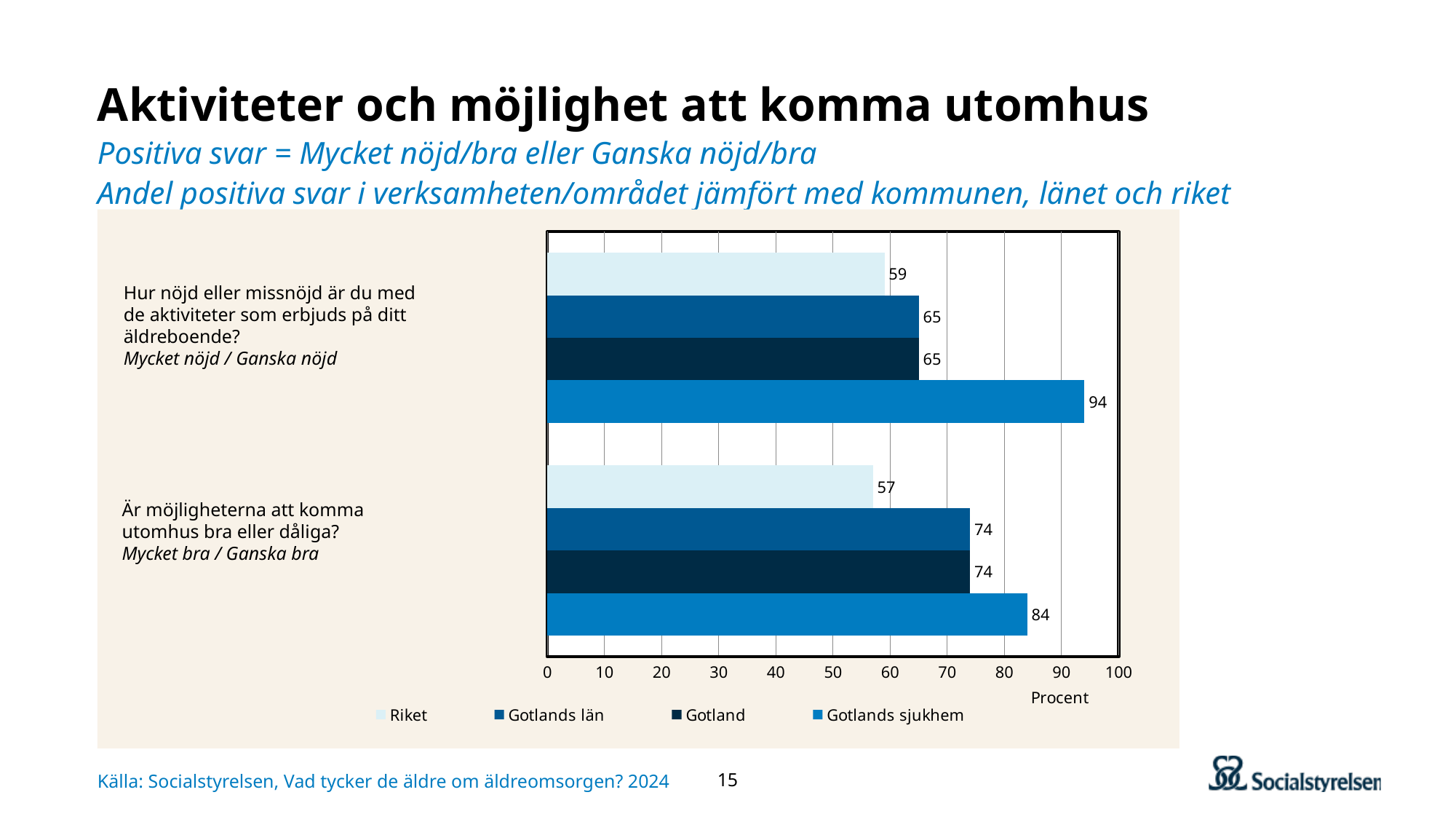
What is the value for Riket on the question about the possibilities to get outdoors? 57 What is the value for Gotlands sjukhem on the question about satisfaction with activities offered at the care home? 94 Which series has the highest value on the question about satisfaction with activities offered? Gotlands sjukhem What is the difference between Gotlands sjukhem and Gotlands län on the question about the possibilities to get outdoors? 10 How many series does the legend list? 4 What kind of chart is shown on the slide? Bar chart Which is larger for Gotlands sjukhem: the value for the activities question or the value for the getting outdoors question? The activities question What is the value for Gotlands län on the question about satisfaction with activities offered? 65 Which series has the lowest value on the question about the possibilities to get outdoors? Riket What is the difference between Gotlands sjukhem and Riket on the question about satisfaction with activities offered? 35 What unit is shown on the horizontal axis of the chart? Procent What is the value for Gotland on the question about the possibilities to get outdoors? 74